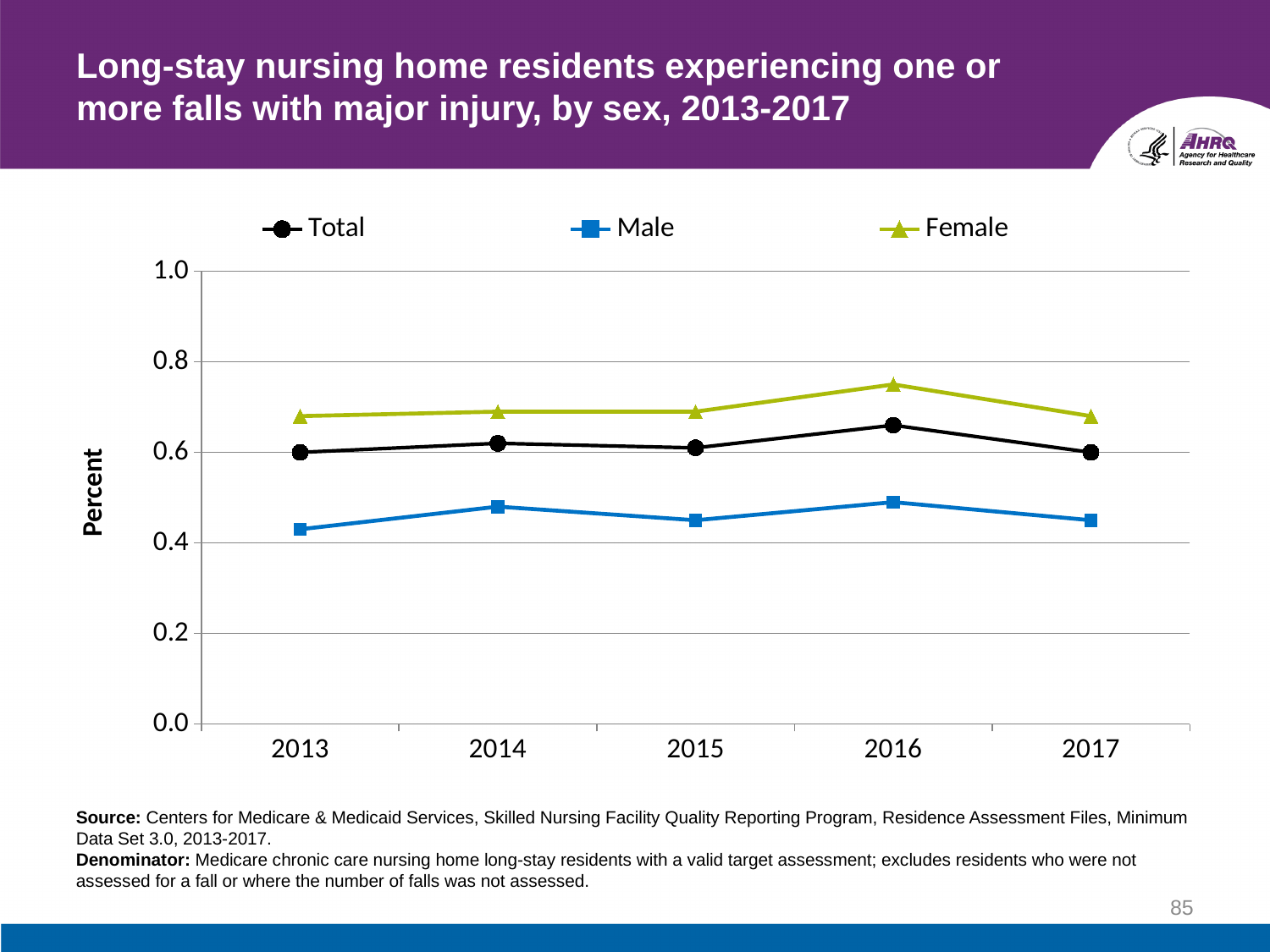
Does the Female series rise or fall from 2016 to 2017? fall Which series has the highest values across all years? Female In which year does the Total series reach its highest value? 2016 What kind of chart is shown on the slide? line chart How many series does the legend list? 3 In which year does the Female series reach its highest value? 2016 Is the value for Female in 2013 greater or less than 0.8? less How many years are plotted along the x axis? 5 Which series has the lowest values across all years? Male In 2015, which is larger, the value for Female or the value for Male? Female Is the value for Male in 2013 greater or less than 0.6? less Is the value for Female in 2016 greater or less than 0.6? greater